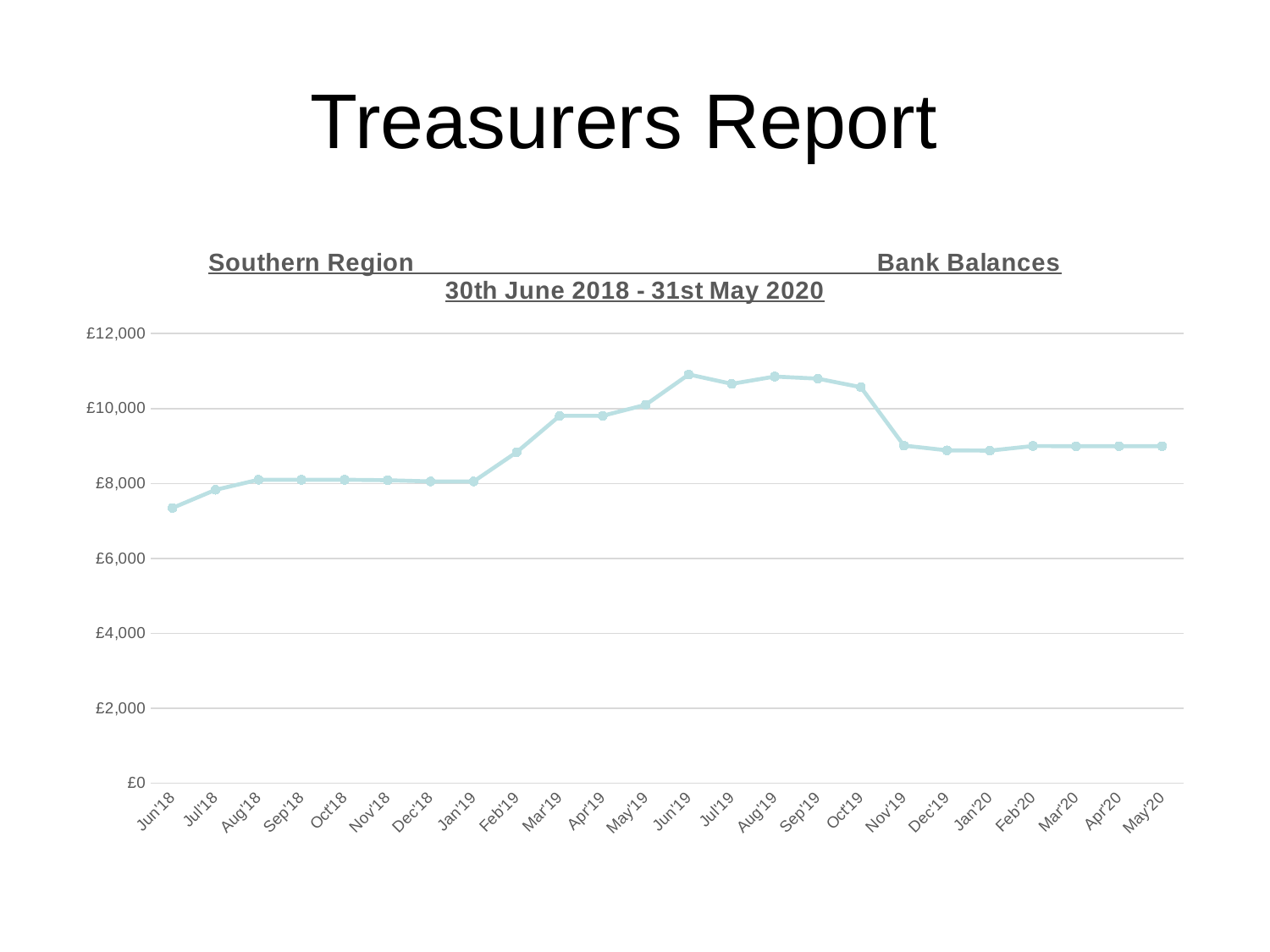
Is the value for Jun'19 greater or less than £10,000? greater Is the value for Dec'19 greater or less than £8,000? greater Which is larger, the value for Oct'19 or the value for Nov'19? Oct'19 Do the values generally rise or fall from Jun'18 to Jun'19? rise Is the value for Feb'19 greater or less than £10,000? less Which month has the lowest bank balance on the chart? Jun'18 What kind of chart is shown on the slide? line chart Which is larger, the value for Jun'18 or the value for Jun'19? Jun'19 How many monthly data points are plotted on the chart? 24 What date range is given in the chart title? 30th June 2018 - 31st May 2020